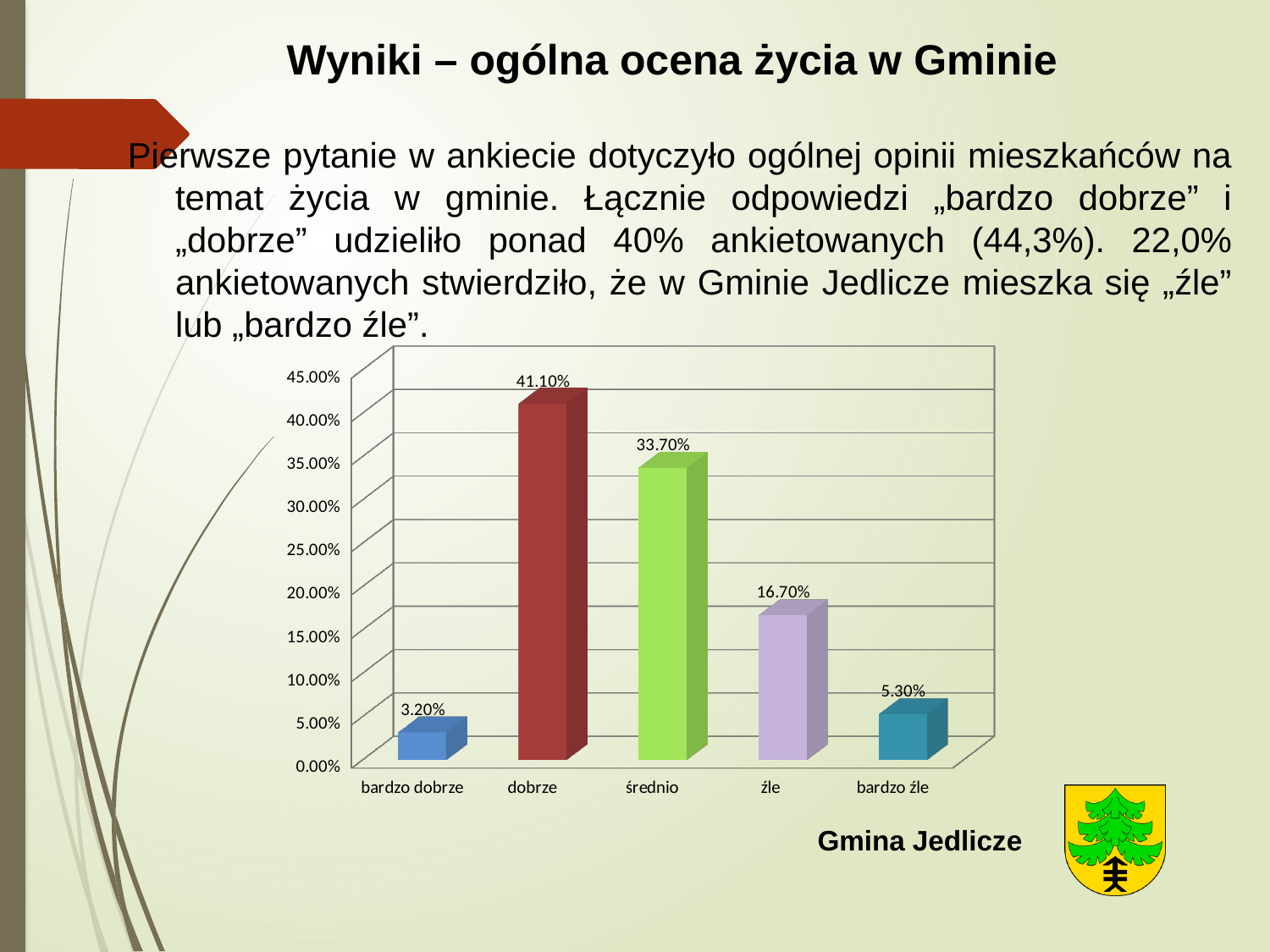
Is the value for "źle" greater or less than 20.00%? less What kind of chart is shown on the slide? bar chart What is the value for "bardzo źle"? 5.30% What colour is the bar for "dobrze"? red Which is larger, the value for "średnio" or the value for "źle"? średnio How many categories are shown on the x axis? 5 Which category has the highest value? dobrze Which category has the lowest value? bardzo dobrze What is the value for "bardzo dobrze"? 3.20% What is the difference between the values for "dobrze" and "średnio"? 7.40% What is the value for "dobrze"? 41.10% What is the difference between the values for "źle" and "bardzo źle"? 11.40%